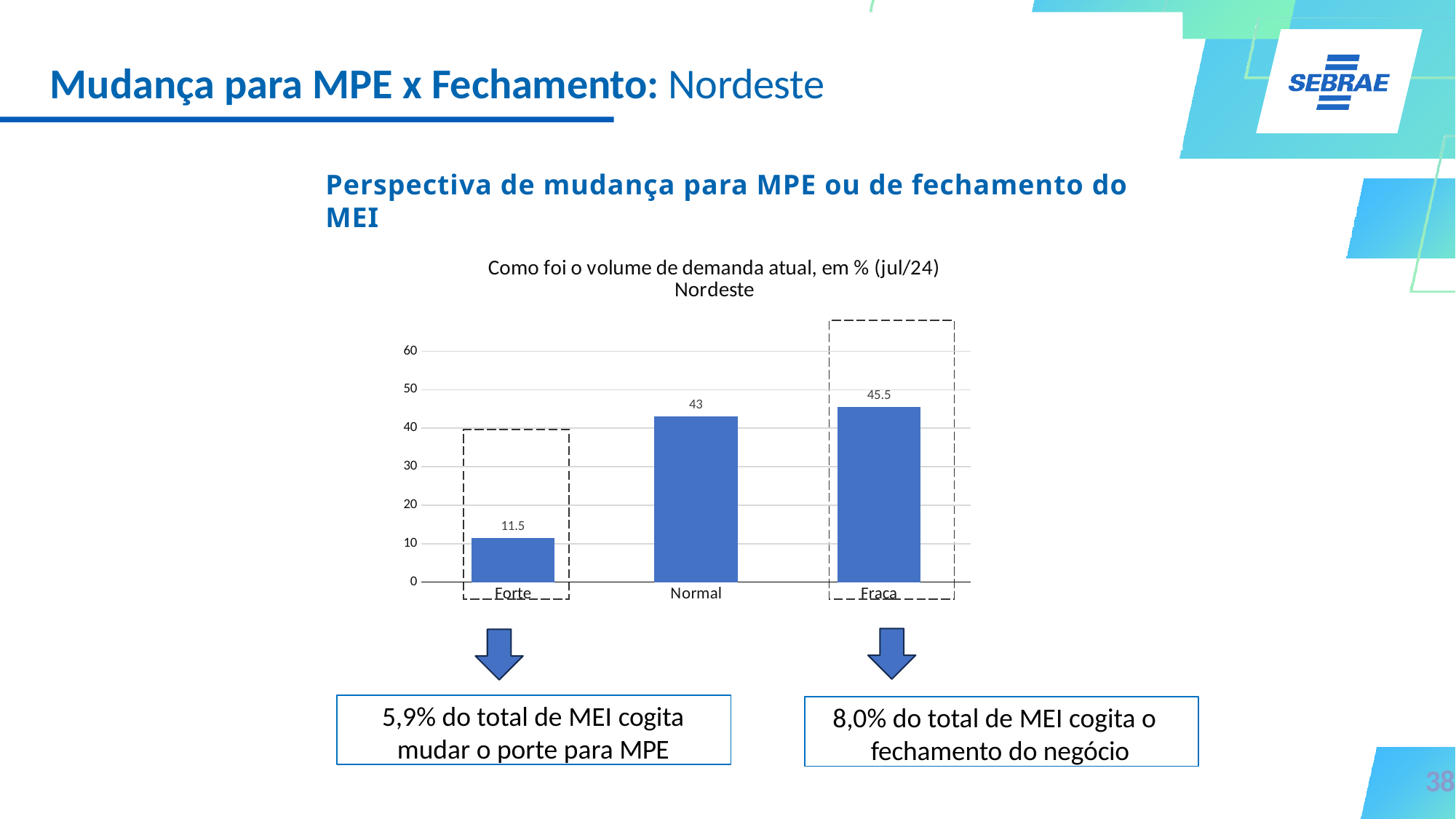
What kind of chart is shown on the slide? bar chart Which is larger, the value for Normal or the value for Forte? Normal Which category has the highest value? Fraca How many categories are shown on the x axis? 3 Which category has the lowest value? Forte What is the title of the chart? Como foi o volume de demanda atual, em % (jul/24) Nordeste What is the value for Forte? 11.5 What is the difference between the values for Fraca and Forte? 34 Is the value for Forte greater or less than 20? less What is the value for Normal? 43 What is the value for Fraca? 45.5 What is the difference between the values for Fraca and Normal? 2.5